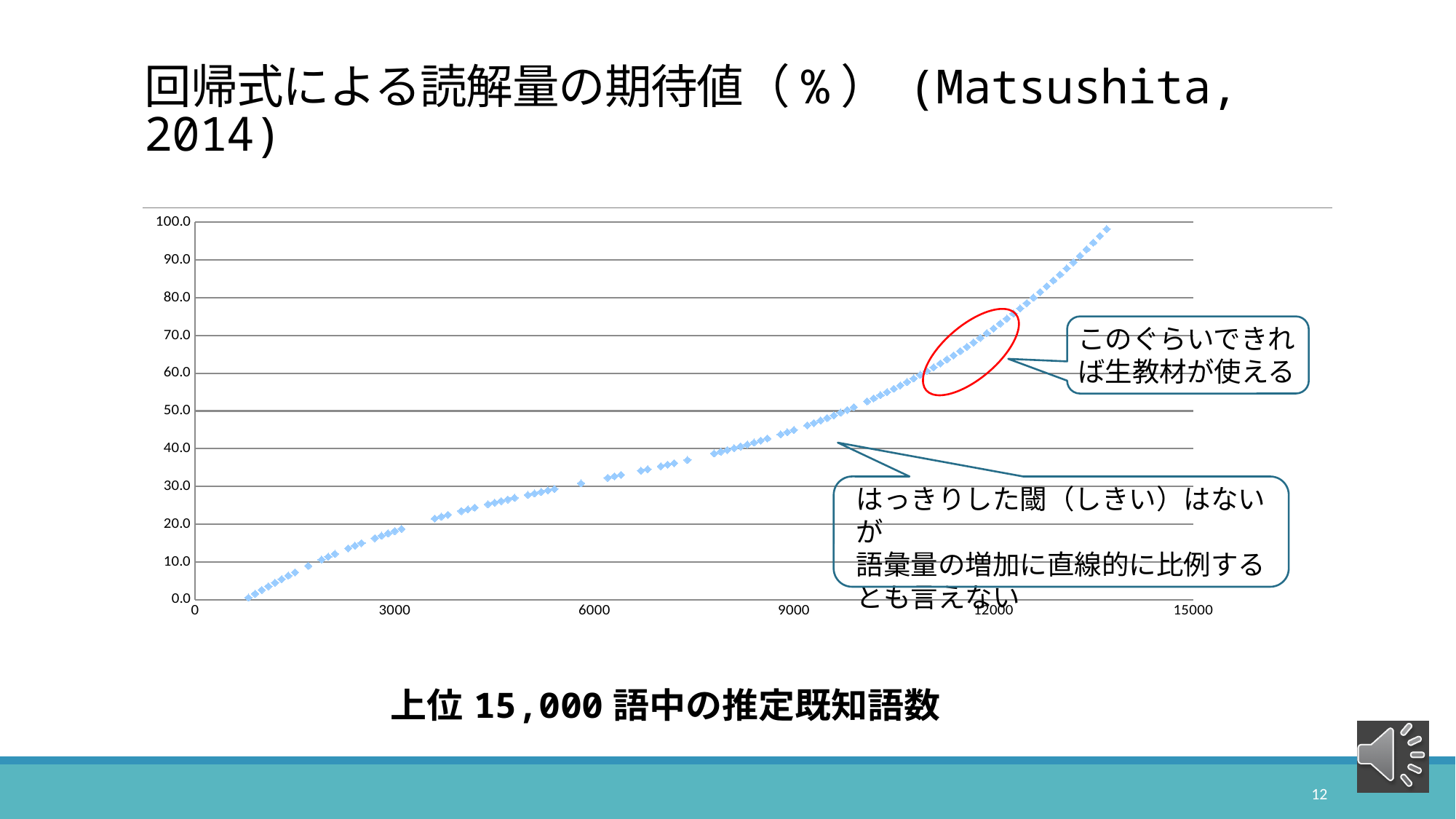
Do the plotted values rise or fall as the x-axis value increases? rise What is the label written below the x-axis of the chart? 上位 15,000 語中の推定既知語数 Is the plotted value at x = 3000 greater or less than 30.0? less Is the lowest plotted value on the chart greater or less than 10.0? less Is the plotted value at x = 6000 greater or less than 40.0? less What kind of chart is shown on the slide? scatter chart What is the highest tick value shown on the y-axis? 100.0